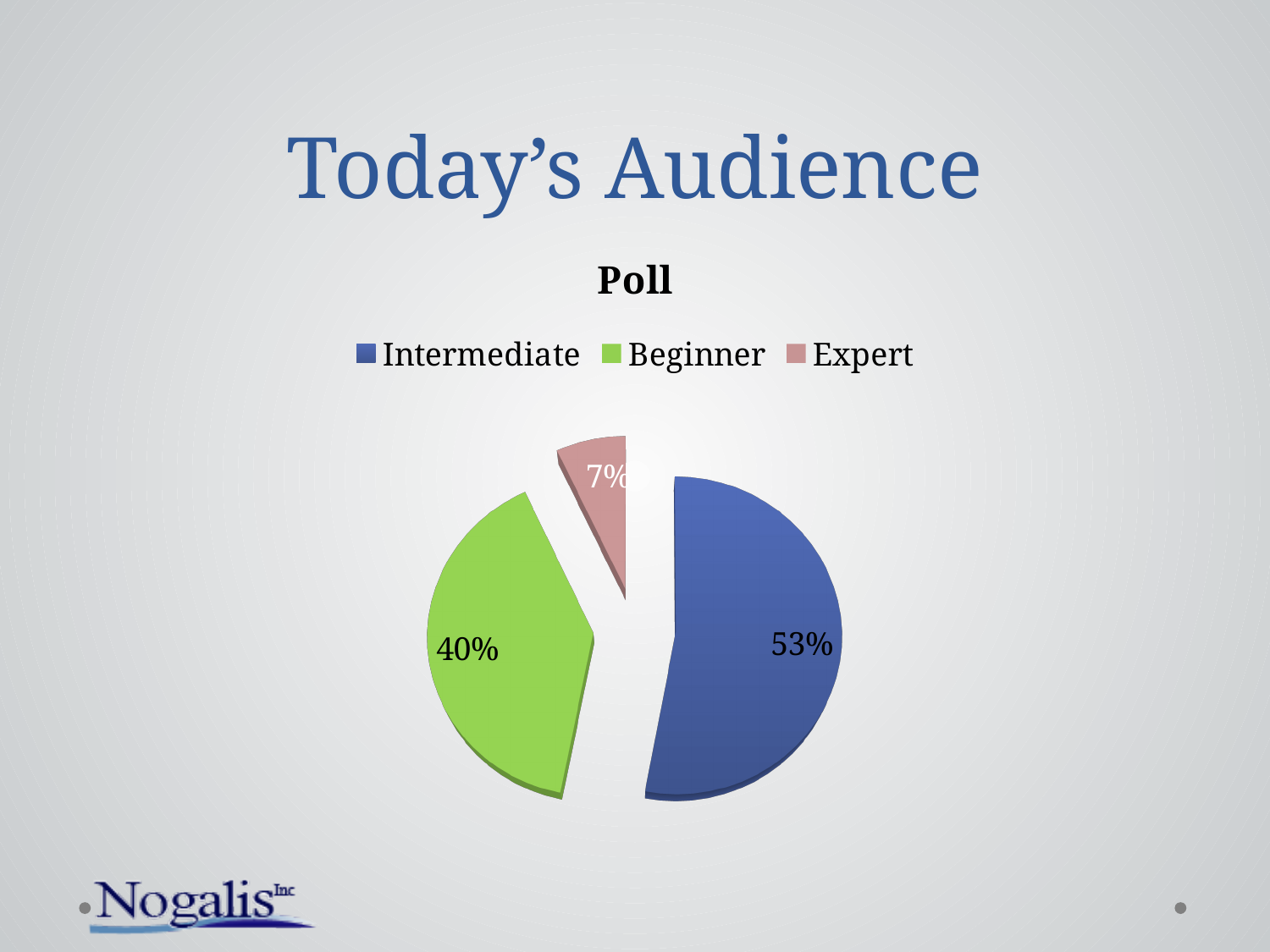
Which is larger, the Beginner slice or the Expert slice? Beginner What kind of chart is shown on the slide? pie chart What colour is the Beginner slice? green What is the chart's title? Poll Which category has the smallest slice? Expert How many slices does the pie chart have? 3 What share of the pie does Beginner have? 40% What is the difference in percentage points between Intermediate and Beginner? 13 What share of the pie does Expert have? 7% Which category has the largest slice? Intermediate What share of the pie does Intermediate have? 53% How many entries does the legend list? 3